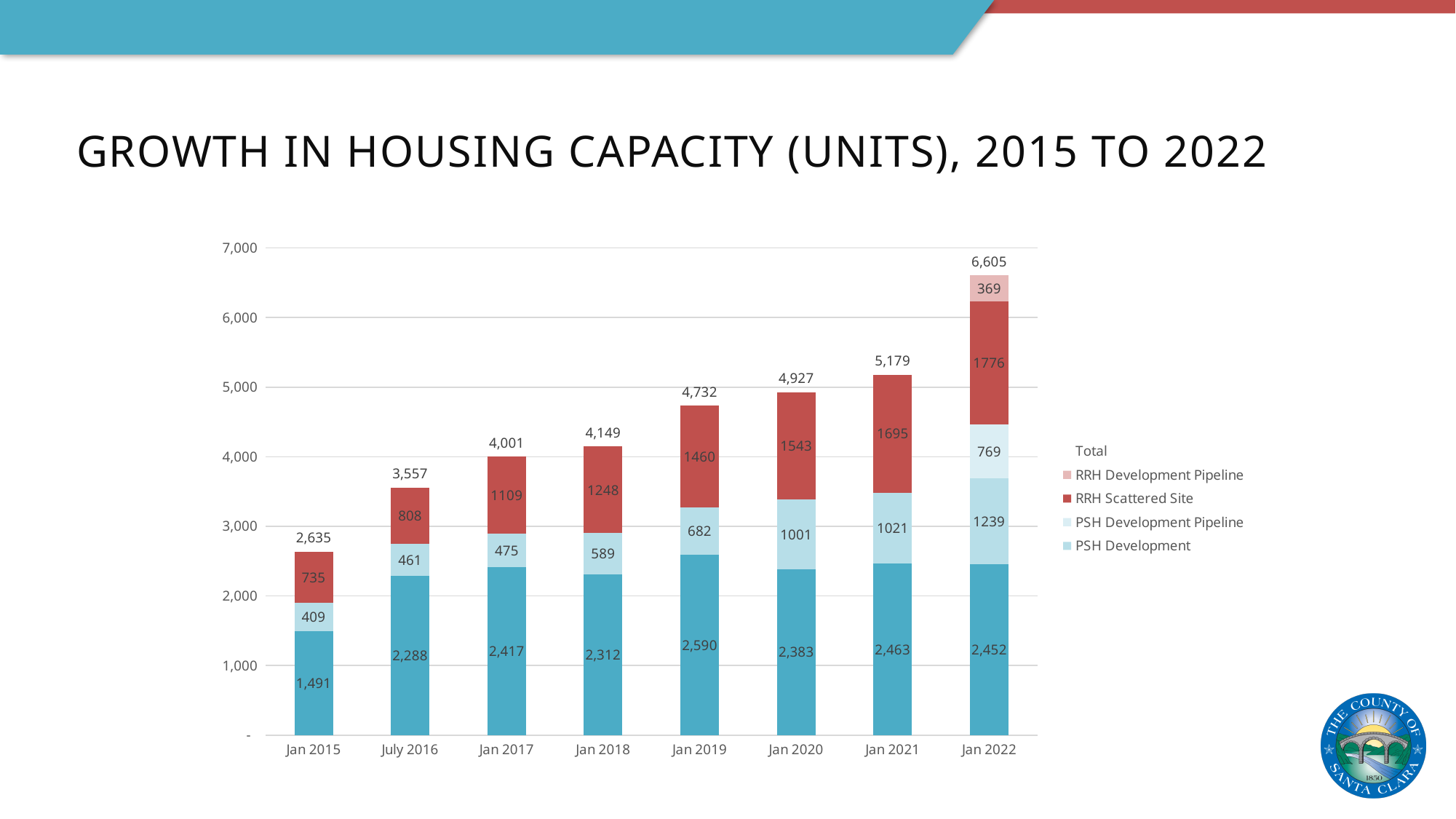
What is the RRH Scattered Site value for Jan 2018? 1248 Which period is the only one with an RRH Development Pipeline segment? Jan 2022 What is the PSH Development value for Jan 2019? 682 Do the total values rise or fall from Jan 2015 to Jan 2022? Rise What type of chart is shown on the slide? Stacked bar chart Which period has the lowest total housing capacity? Jan 2015 Which period has the highest total housing capacity? Jan 2022 How many time periods are shown on the x axis? 8 Which is larger, the RRH Scattered Site value for Jan 2020 or for Jan 2017? Jan 2020 What is the difference between the total for Jan 2022 and the total for Jan 2021? 1,426 What is the total housing capacity shown for Jan 2022? 6,605